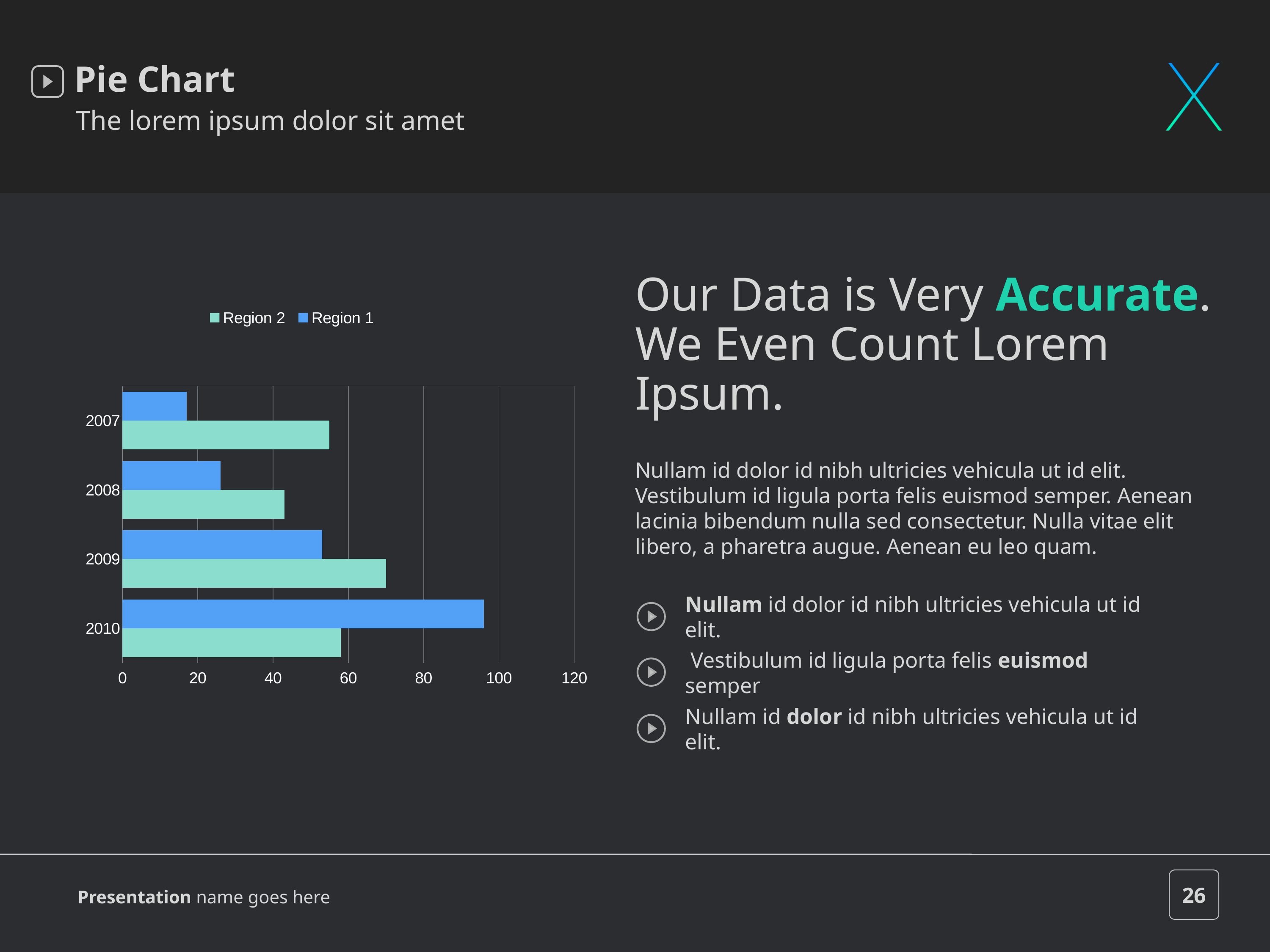
What kind of chart is shown on the slide? bar chart Which year has the lowest value for Region 2? 2008 How many series does the chart's legend list? 2 How many years are shown on the chart's category axis? 4 Which year has the lowest value for Region 1? 2007 In 2007, which series has the larger value, Region 1 or Region 2? Region 2 Which year has the highest value for Region 1? 2010 In 2010, which series has the larger value, Region 1 or Region 2? Region 1 Which year has the highest value for Region 2? 2009 Is the value for Region 1 in 2010 greater or less than 80? greater Do the Region 1 values rise or fall from 2007 to 2010? rise What are the names of the two series in the legend? Region 2 and Region 1